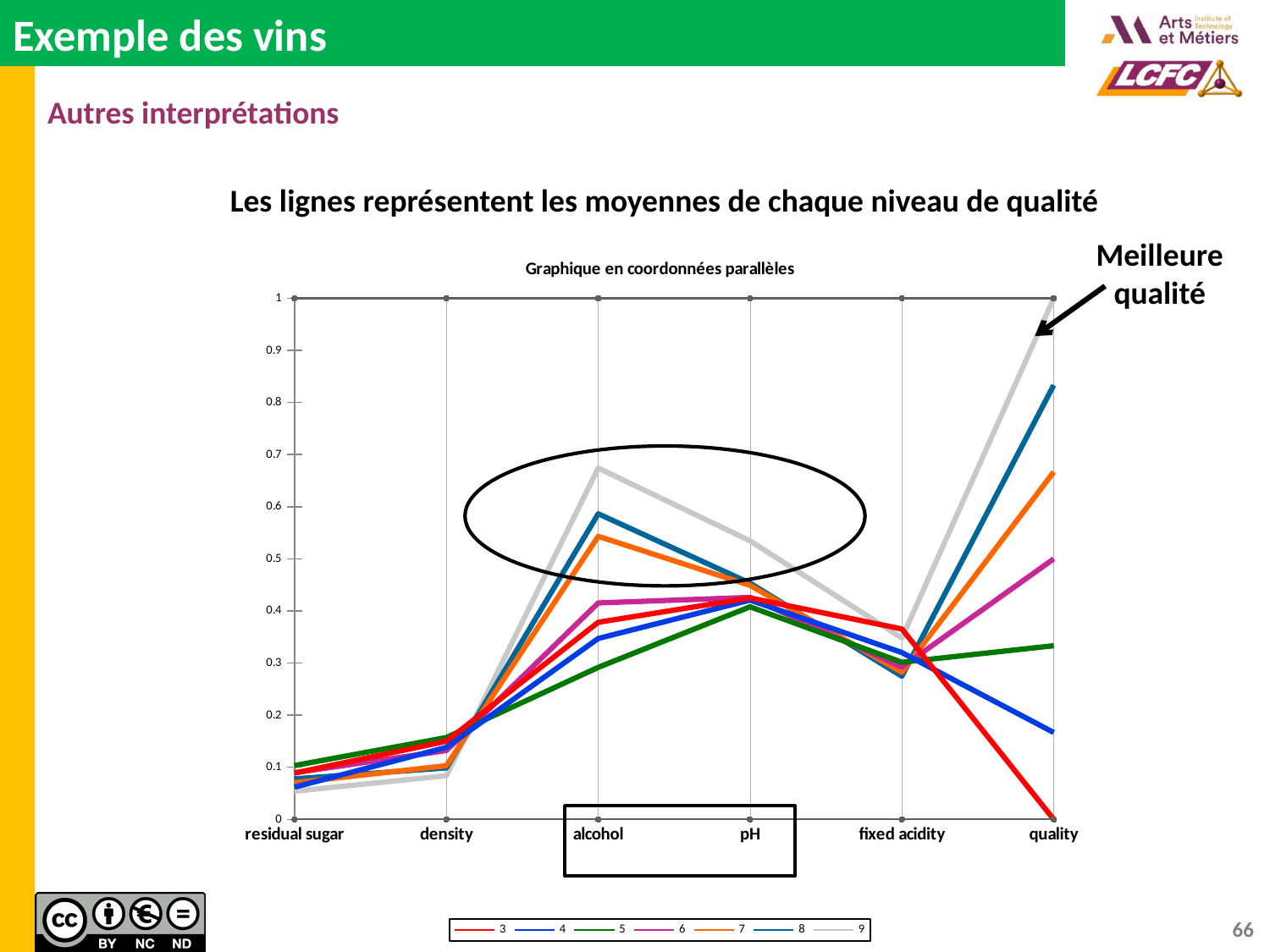
What kind of chart is shown on the slide? line chart (parallel coordinates) Is the value of series 4 on the quality axis greater or less than 0.2? less What is the value of series 3 on the quality axis? 0 Is the value of series 9 on the alcohol axis greater or less than 0.6? greater How many variables (axes) are shown along the x axis? 6 What is the value of series 9 on the quality axis? 1 Which series has the lowest value on the quality axis? 3 What is the title of the chart? Graphique en coordonnées parallèles On the alcohol axis, which is higher: series 8 or series 7? 8 Which series has the highest value on the alcohol axis? 9 How many series does the legend list? 7 Does series 9 rise or fall from residual sugar to alcohol? rise